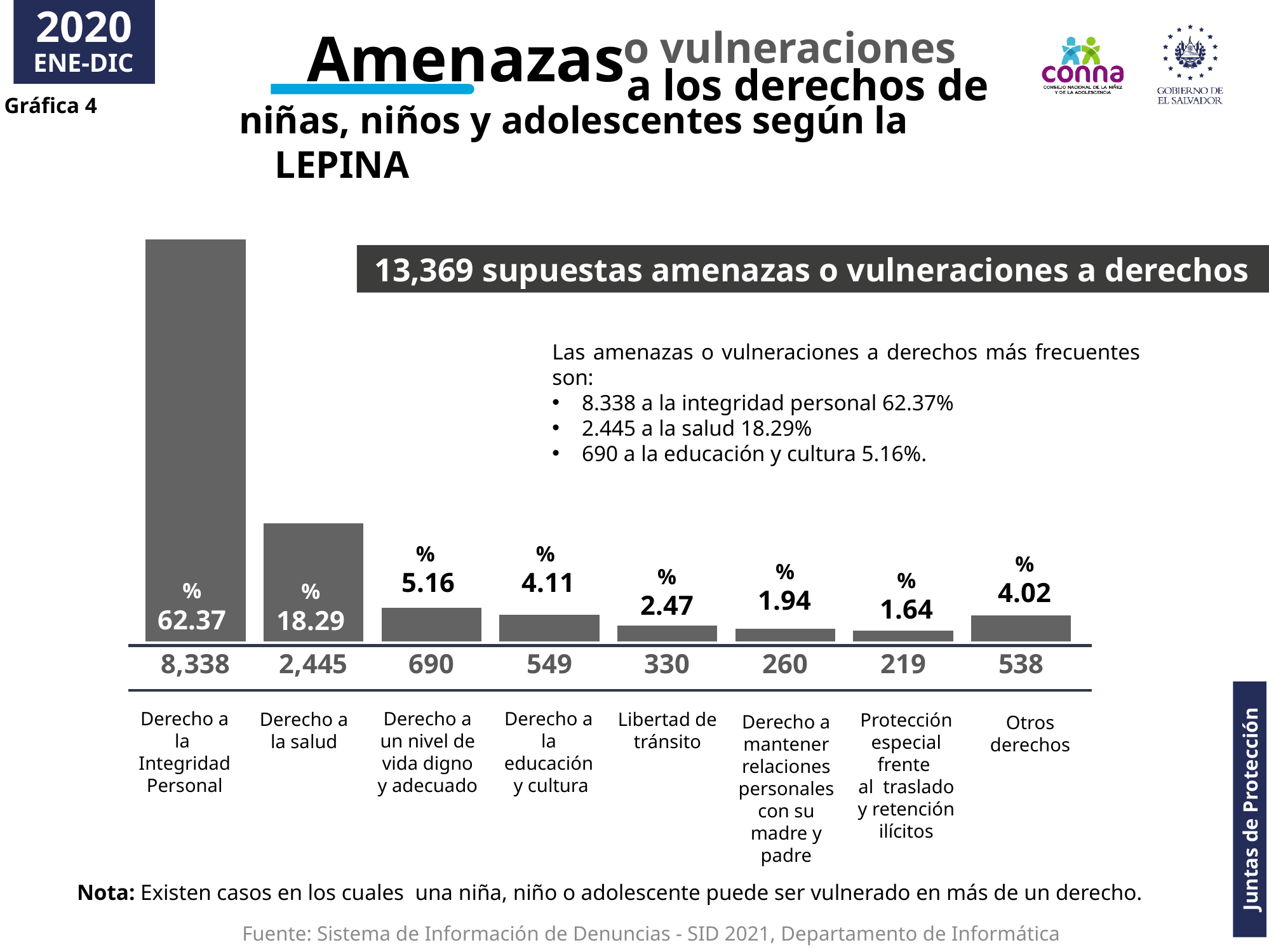
Which has more cases: Derecho a la educación y cultura or Otros derechos? Derecho a la educación y cultura What type of chart is shown on the slide? Bar chart How many categories are shown in the bar chart? 8 What total number of supposed threats or violations is stated in the banner on the slide? 13,369 What percentage is shown for Derecho a la Integridad Personal? 62.37 What is the difference in cases between Derecho a un nivel de vida digno y adecuado and Derecho a la educación y cultura? 141 What is the number of cases for Libertad de tránsito? 330 Which category has the lowest number of cases? Protección especial frente al traslado y retención ilícitos What is the difference in cases between Derecho a la Integridad Personal and Derecho a la salud? 5,893 What percentage is shown for Otros derechos? 4.02 What is the number of cases for Derecho a la salud? 2,445 Which category has the highest number of cases? Derecho a la Integridad Personal